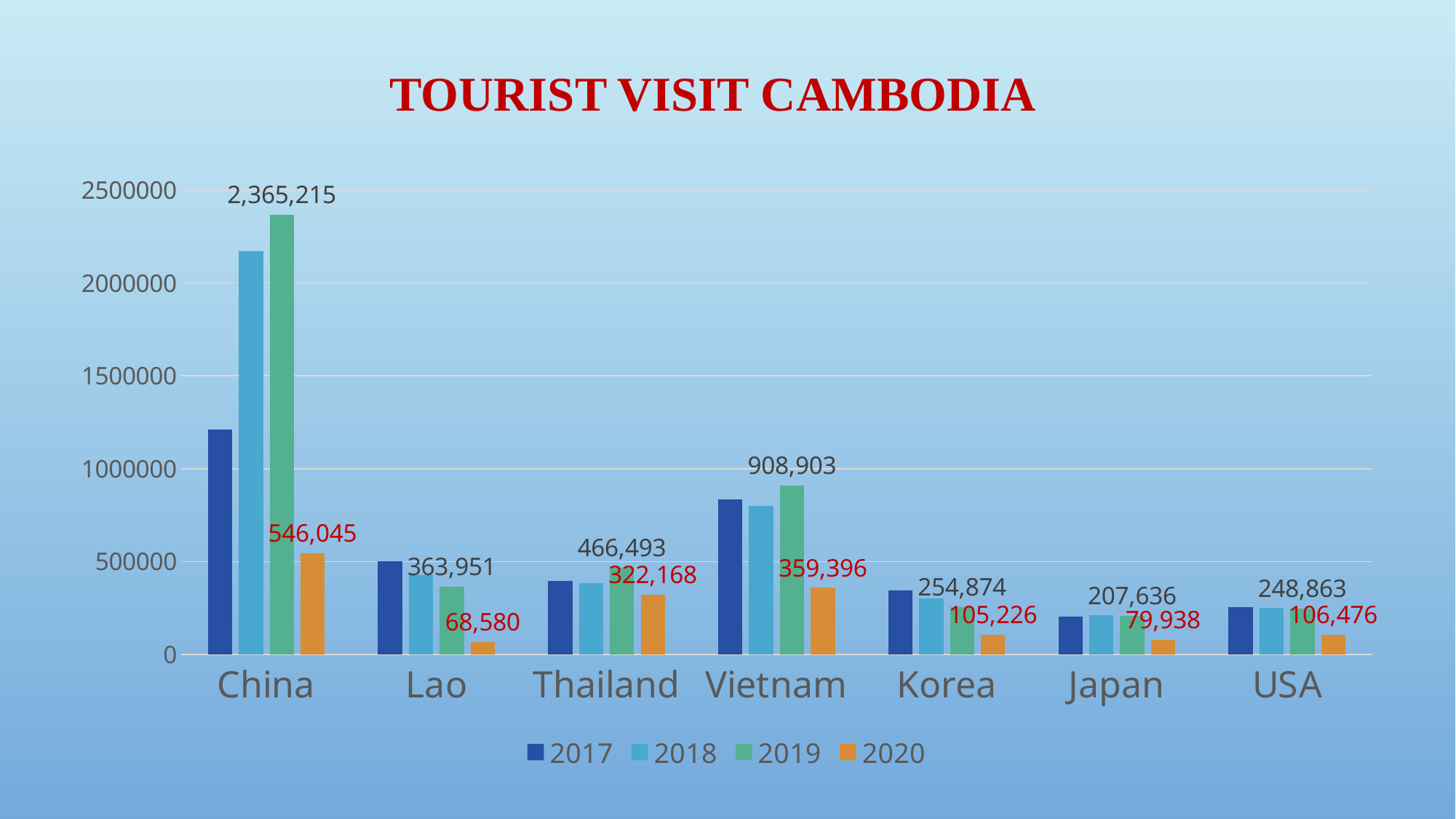
What was the number of tourists from Lao in 2020? 68,580 What type of chart is shown on the slide? Bar chart What is the difference between the 2019 and 2020 values for China? 1,819,170 Is the value for China in 2017 greater or less than 1000000? greater How many series does the legend list? 4 Which is larger, the 2020 value for Thailand or the 2020 value for Korea? Thailand How many countries are shown on the x axis? 7 What was the number of tourists from Vietnam in 2020? 359,396 Which country had the lowest number of tourists in 2019? Japan What was the number of tourists from China in 2019? 2,365,215 Which country had the highest number of tourists in 2020? China What is the difference between the 2019 and 2020 values for Vietnam? 549,507